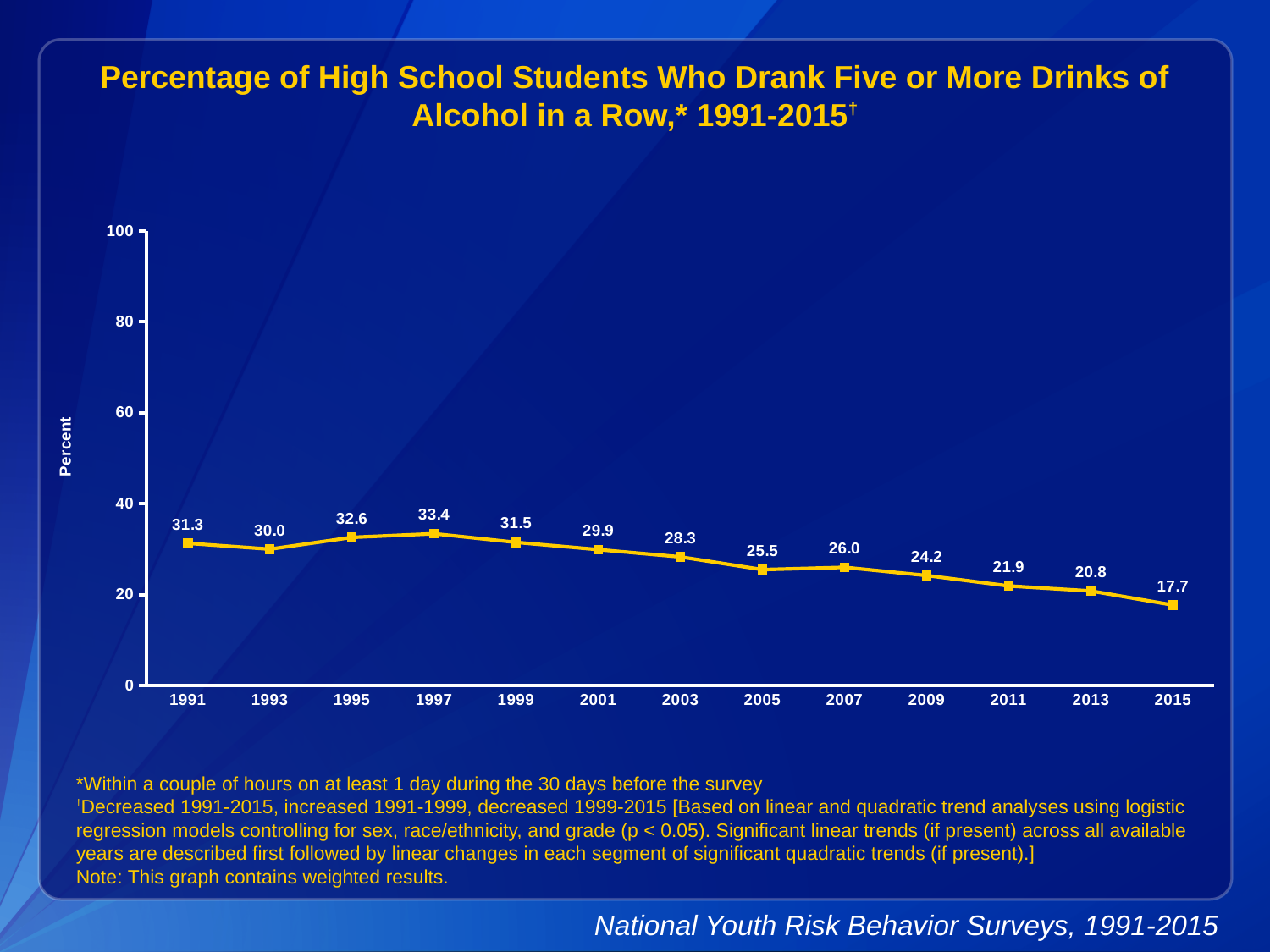
Is the value for 2011 greater or less than 40? less What is the difference between the 1997 value and the 2015 value? 15.7 What kind of chart is shown on the slide? Line chart Which year has the highest value on the chart? 1997 What was the percentage of high school students who drank five or more drinks in a row in 1991? 31.3 What is the label on the vertical axis? Percent Which year has a larger value, 1993 or 1995? 1995 How many years are plotted on the chart? 13 Do the values generally rise or fall from 1999 to 2015? Fall What value is shown for 2005? 25.5 What value is shown for 2015? 17.7 Which year has the lowest value on the chart? 2015